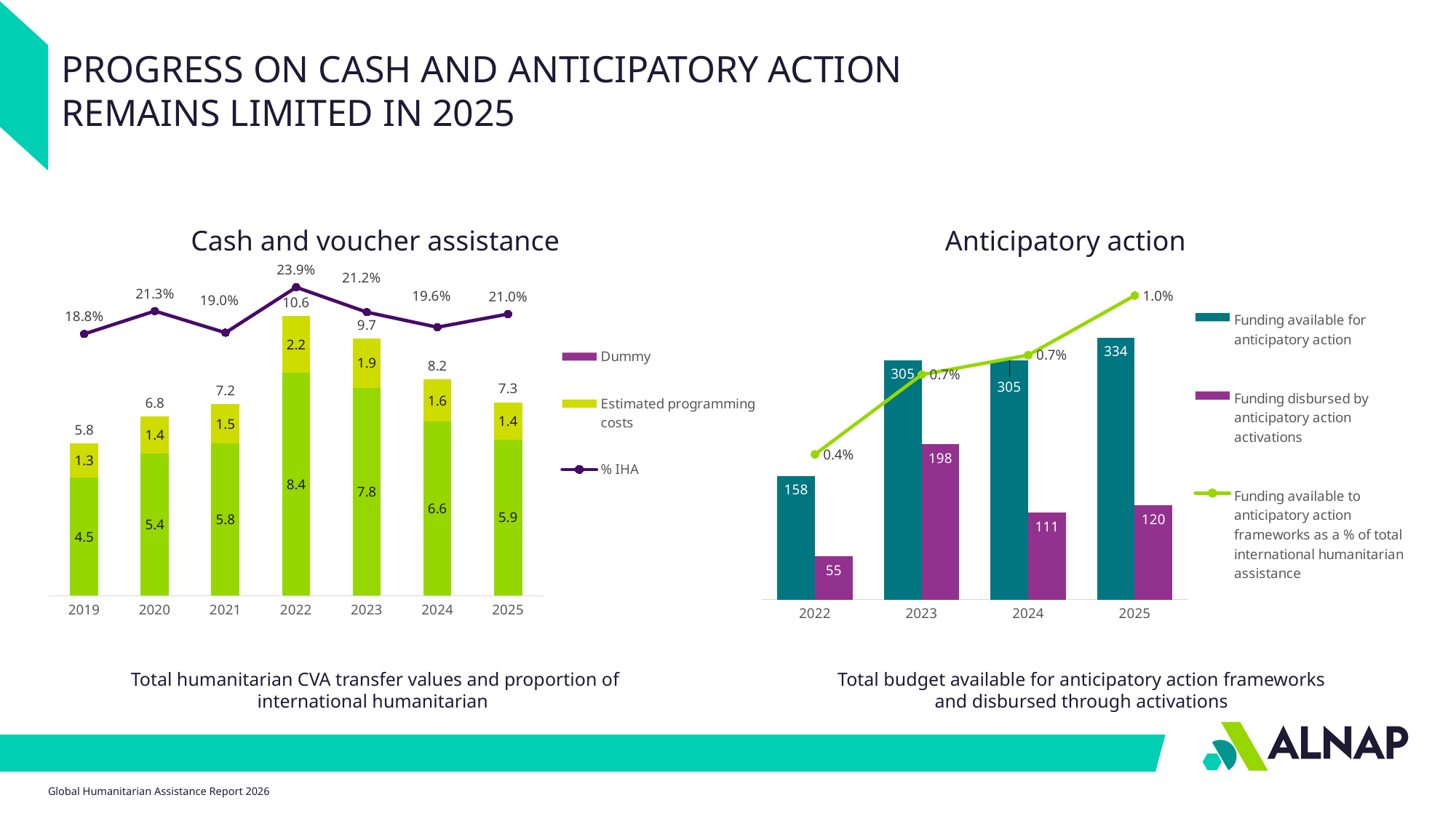
In the Anticipatory action chart, what is the difference between funding available and funding disbursed in 2022? 103 In the Cash and voucher assistance chart, what is the Estimated programming costs value for 2023? 1.9 In the Anticipatory action chart, what is the Funding disbursed by anticipatory action activations value for 2023? 198 How many years are shown on the x axis of the Cash and voucher assistance chart? 7 How many series does the legend of the Anticipatory action chart list? 3 In the Anticipatory action chart, what is the Funding available for anticipatory action value for 2025? 334 In the Anticipatory action chart, does the line for funding available as a % of total international humanitarian assistance rise or fall from 2022 to 2025? rise In the Cash and voucher assistance chart, what is the % IHA value for 2019? 18.8% In the Cash and voucher assistance chart, in which year is the % IHA line at its highest? 2022 In the Anticipatory action chart, what percentage of total international humanitarian assistance is shown for 2025? 1.0% In the Cash and voucher assistance chart, what is the total value shown above the bar for 2022? 10.6 In the Cash and voucher assistance chart, what is the difference between the bar totals for 2022 and 2025? 3.3